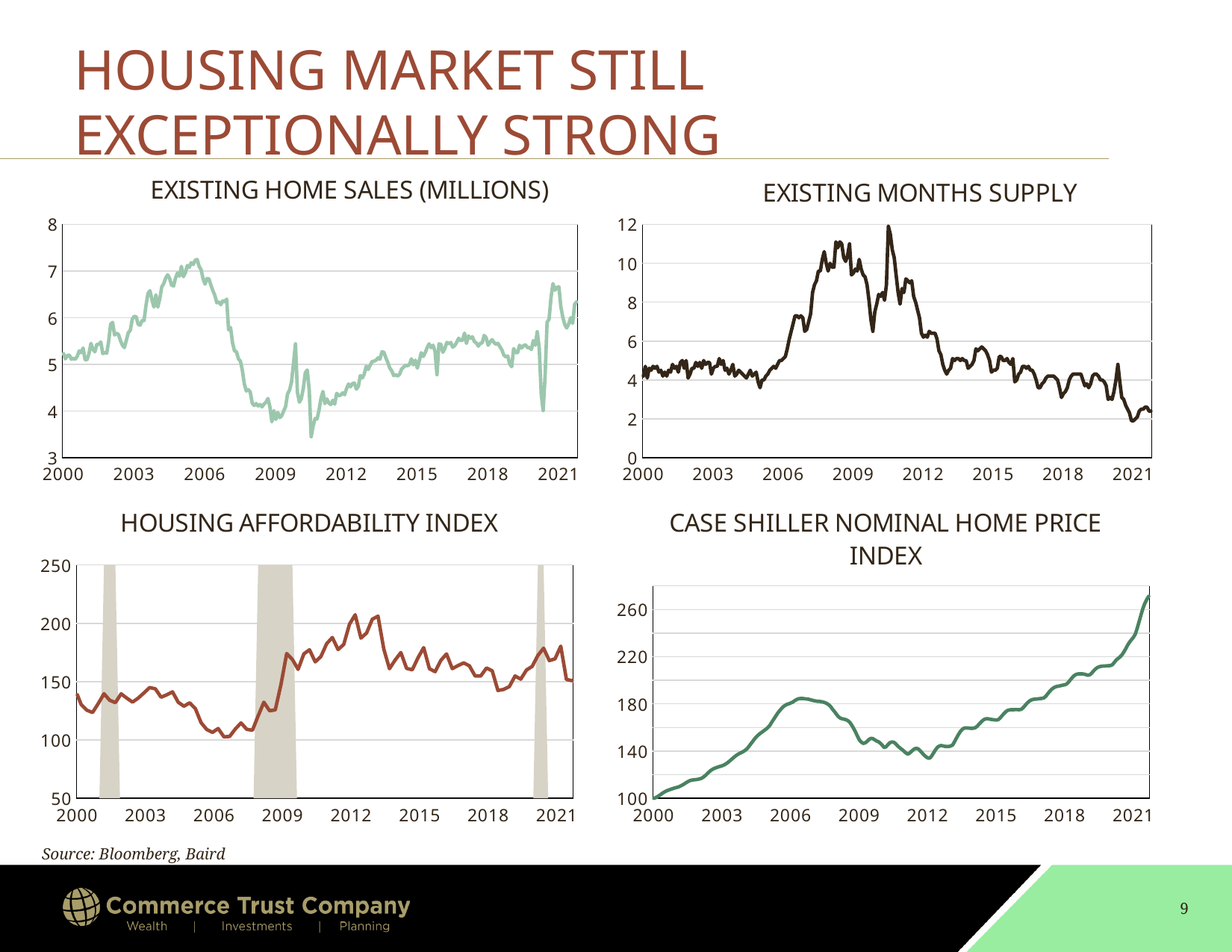
On the Existing Months Supply chart, is the highest value on the line greater or less than 10? greater What is the lowest value shown on the y axis of the Housing Affordability Index chart? 50 On the Existing Home Sales (Millions) chart, is the value at 2000 greater or less than 6? less How many charts are shown on the slide? 4 What kind of chart is the Existing Home Sales (Millions) chart? line chart On the Case Shiller Nominal Home Price Index chart, is the value at 2021 greater or less than 220? greater On the Case Shiller Nominal Home Price Index chart, which is larger, the value at 2006 or the value at 2021? 2021 On the Case Shiller Nominal Home Price Index chart, do values rise or fall from 2012 to 2021? rise What is the title of the top-left chart? EXISTING HOME SALES (MILLIONS) On the Existing Months Supply chart, do values rise or fall from 2012 to 2021? fall